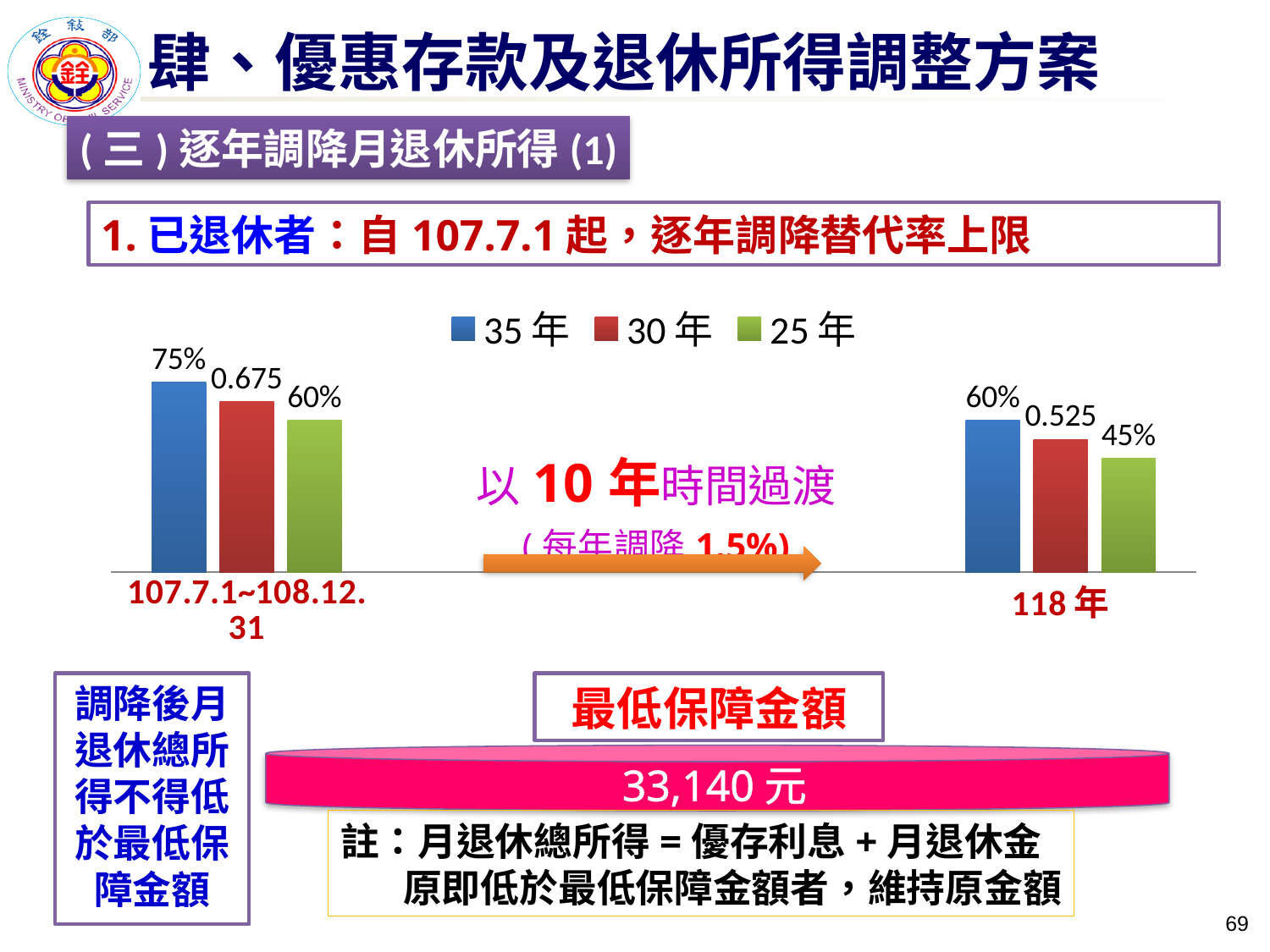
How many categories are shown on the x axis of the chart? 2 What is the value for the 25 年 series in the 118 年 category? 45% What is the value for the 30 年 series in the 118 年 category? 0.525 Which series has the highest value in the 118 年 category? 35 年 What is the difference between the 35 年 value in 107.7.1~108.12.31 and the 35 年 value in 118 年? 15% How many series does the chart legend list? 3 What kind of chart is shown on the slide? Bar chart What is the value for the 30 年 series in the 107.7.1~108.12.31 category? 0.675 Which series has the lowest value in the 107.7.1~108.12.31 category? 25 年 Do the values for each series rise or fall from 107.7.1~108.12.31 to 118 年? Fall Which is larger: the 25 年 value in 107.7.1~108.12.31 or the 25 年 value in 118 年? 107.7.1~108.12.31 What is the value for the 35 年 series in the 107.7.1~108.12.31 category? 75%